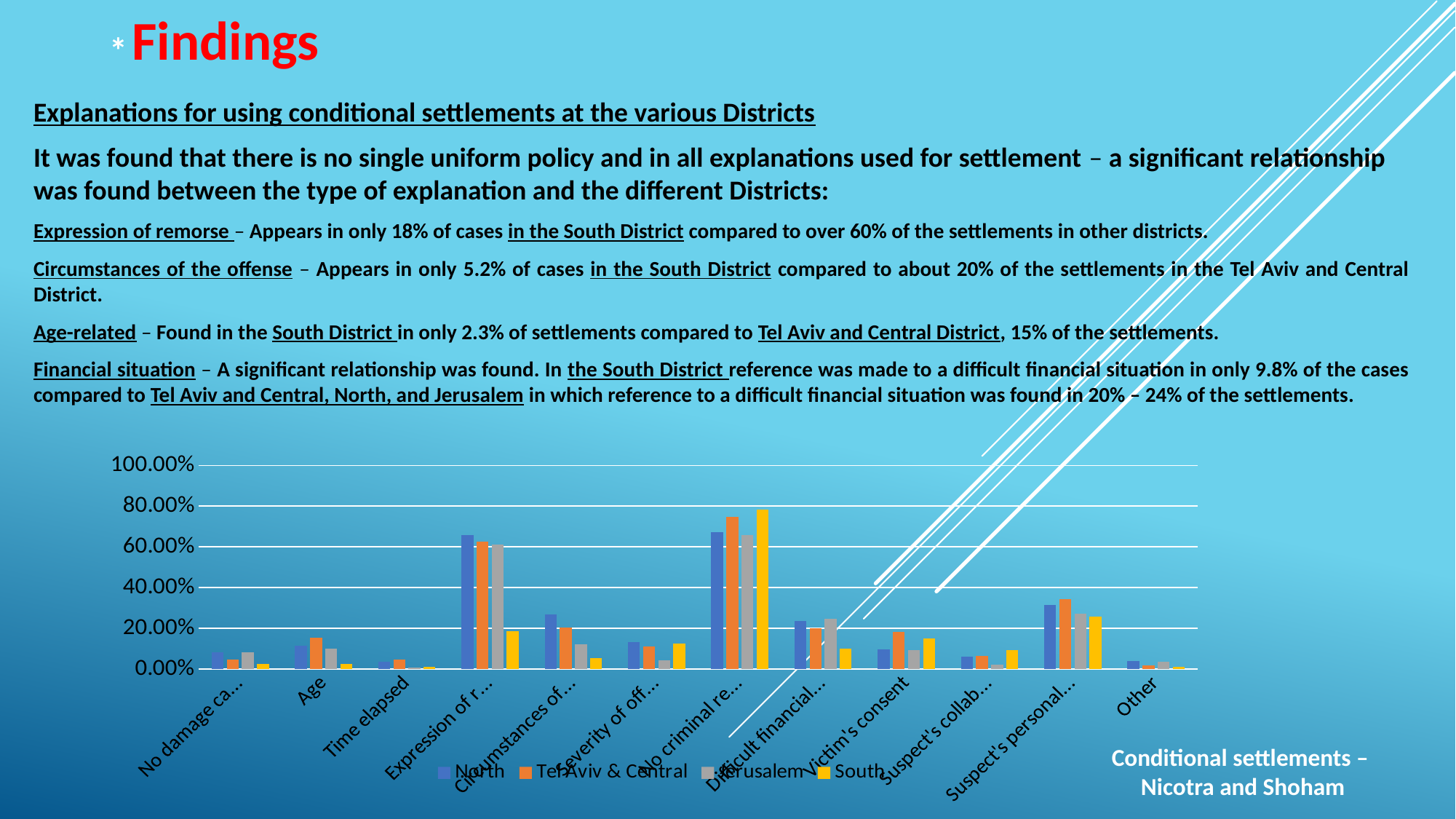
Is the South value for 'No criminal re...' greater or less than 60.00%? greater In the 'Expression of r...' category, which is larger: the North bar or the South bar? North How many series does the chart legend list? 4 In the 'Expression of r...' category, which series has the lowest bar? South In the 'No criminal re...' category, which is larger: the South bar or the North bar? South Which series does the legend show in yellow? South In the 'Circumstances of...' category, which series has the highest bar? North Is the North value for 'Age' greater or less than 20.00%? less What kind of chart is shown on the slide? bar chart Which series does the legend show in blue? North How many categories are shown along the x axis of the chart? 12 Is the South value for 'Expression of r...' greater or less than 40.00%? less